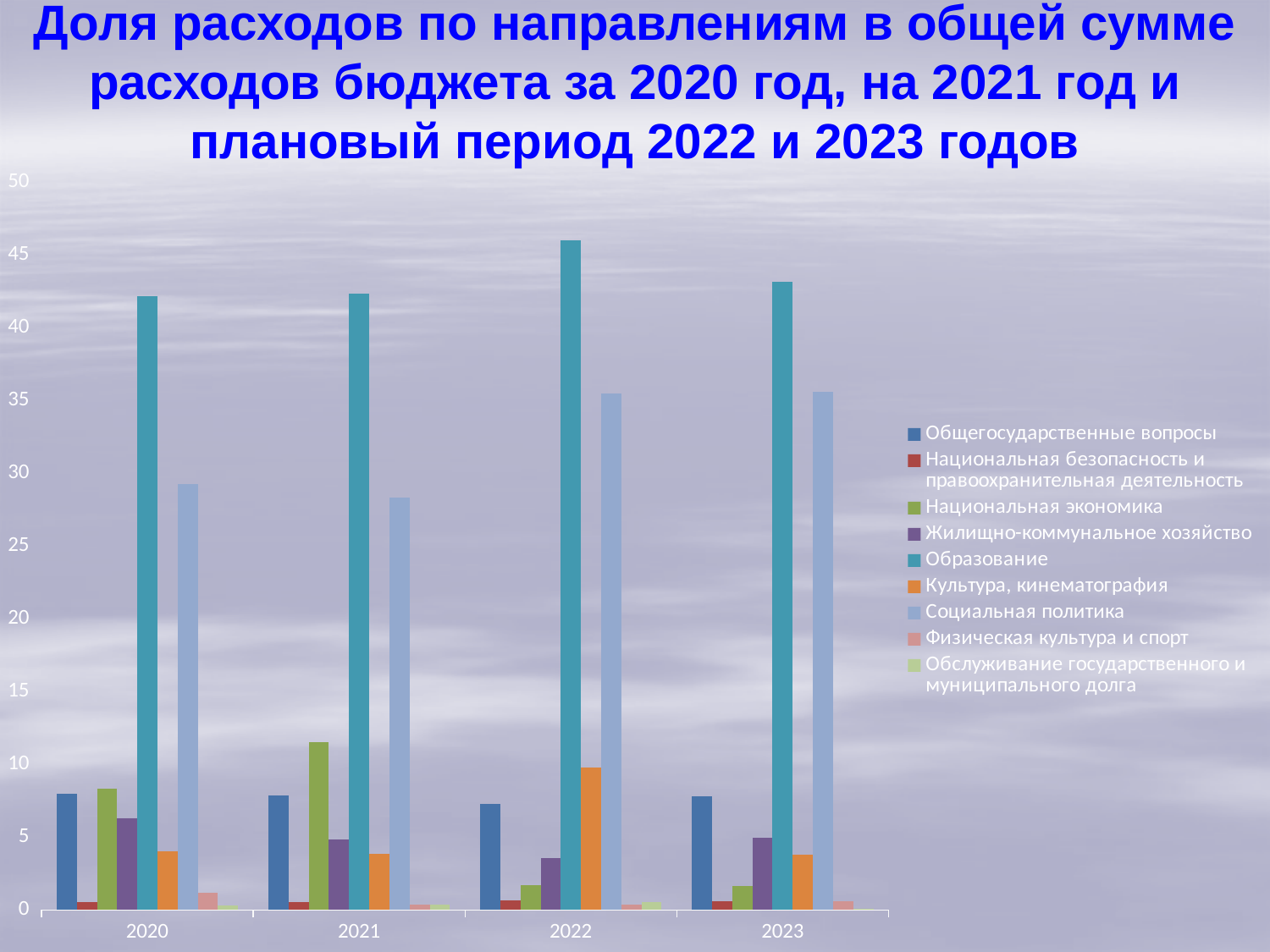
How many years (categories) are shown on the x axis? 4 Does the value for Социальная политика rise or fall from 2020 to 2022? rise Which is larger: Социальная политика in 2022 or Социальная политика in 2020? 2022 How many series does the legend list? 9 Is the value for Общегосударственные вопросы in 2020 greater or less than 10? less Which is larger: Национальная экономика in 2021 or Национальная экономика in 2023? 2021 Is the value for Социальная политика in 2020 greater or less than 30? less What kind of chart is shown on the slide? bar chart Is the value for Образование in 2022 greater or less than 45? greater In which year is the value for Образование the highest? 2022 Which series has the highest value in 2020? Образование